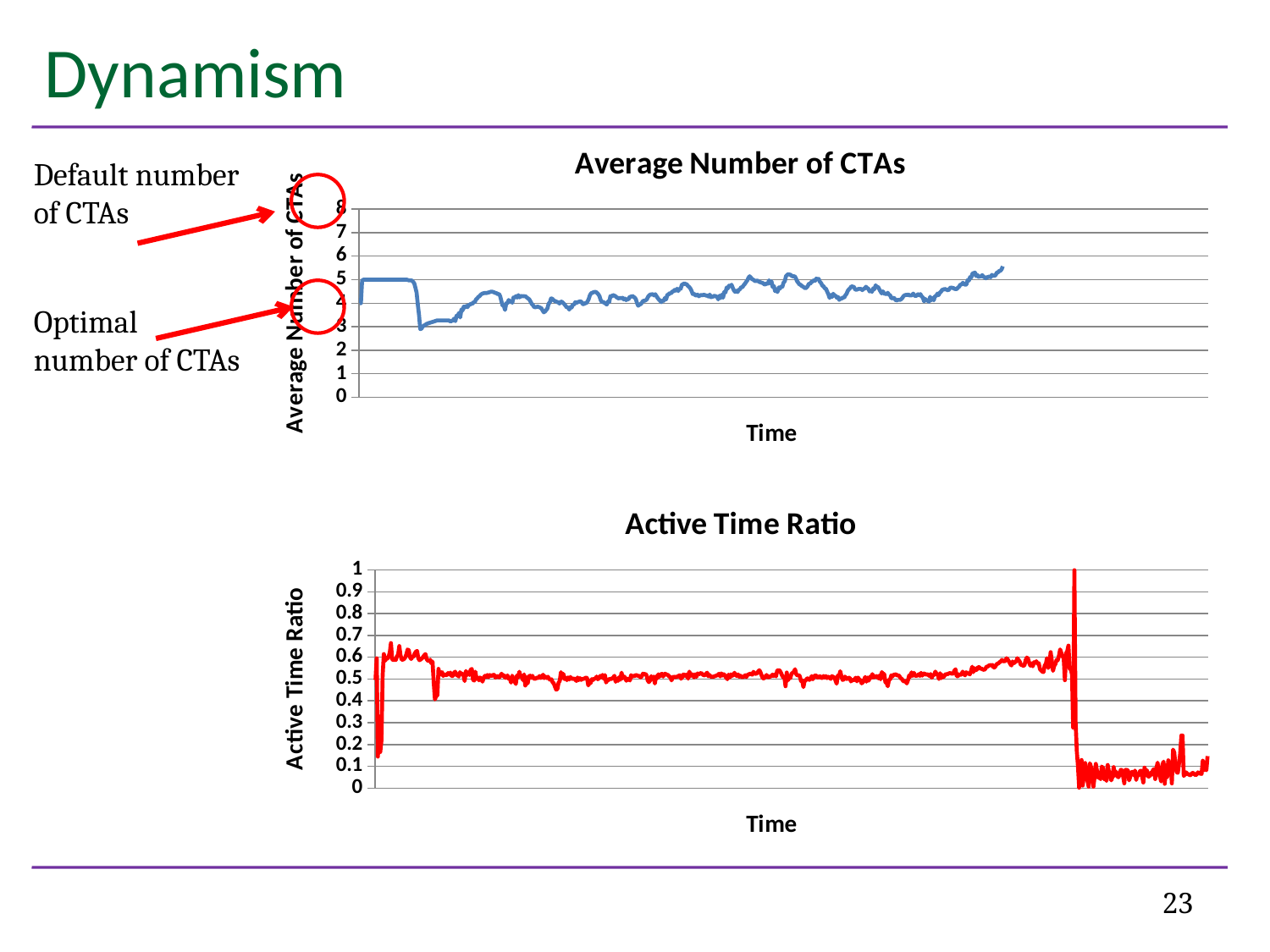
In the 'Active Time Ratio' chart, is the value of the line around the middle of the time axis greater or less than 0.3? greater In the 'Active Time Ratio' chart, does the line rise or fall sharply near the right end of the time axis? fall What is the highest tick value shown on the y axis of the 'Average Number of CTAs' chart? 8 In the 'Average Number of CTAs' chart, is the highest value reached by the line greater or less than 6? less What kind of chart is the 'Average Number of CTAs' chart? line chart In the 'Average Number of CTAs' chart, is the lowest point reached by the line greater or less than 4? less In the 'Average Number of CTAs' chart, after the early dip, does the line generally rise or fall toward the right end of the time axis? rise What kind of chart is the 'Active Time Ratio' chart? line chart What is the label of the x axis on the 'Active Time Ratio' chart? Time